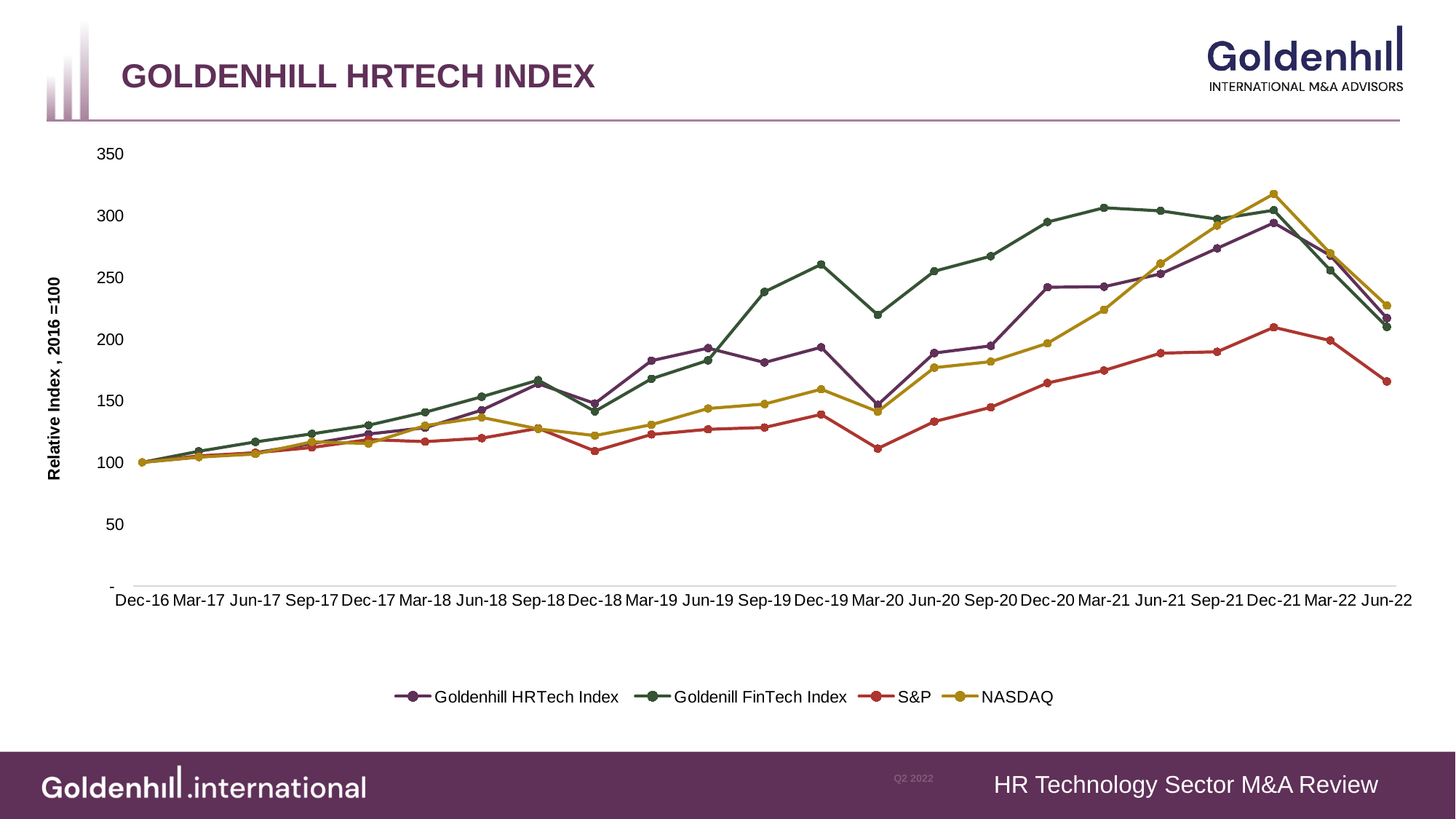
Is the value for S&P at Jun-22 greater or less than 200? less Which series has the highest value at Dec-21? NASDAQ Is the value for the Goldenill FinTech Index at Sep-19 greater or less than 200? greater Does the Goldenhill HRTech Index rise or fall from Dec-21 to Jun-22? fall Is the value for NASDAQ at Dec-21 greater or less than 300? greater At Sep-19, which is larger: the Goldenill FinTech Index or the Goldenhill HRTech Index? Goldenill FinTech Index What is the value of the Goldenhill HRTech Index at Dec-16? 100 Which series has the lowest value at Jun-22? S&P How many series does the legend list? 4 What kind of chart is shown on the slide? line chart How many time points are plotted along the x axis? 23